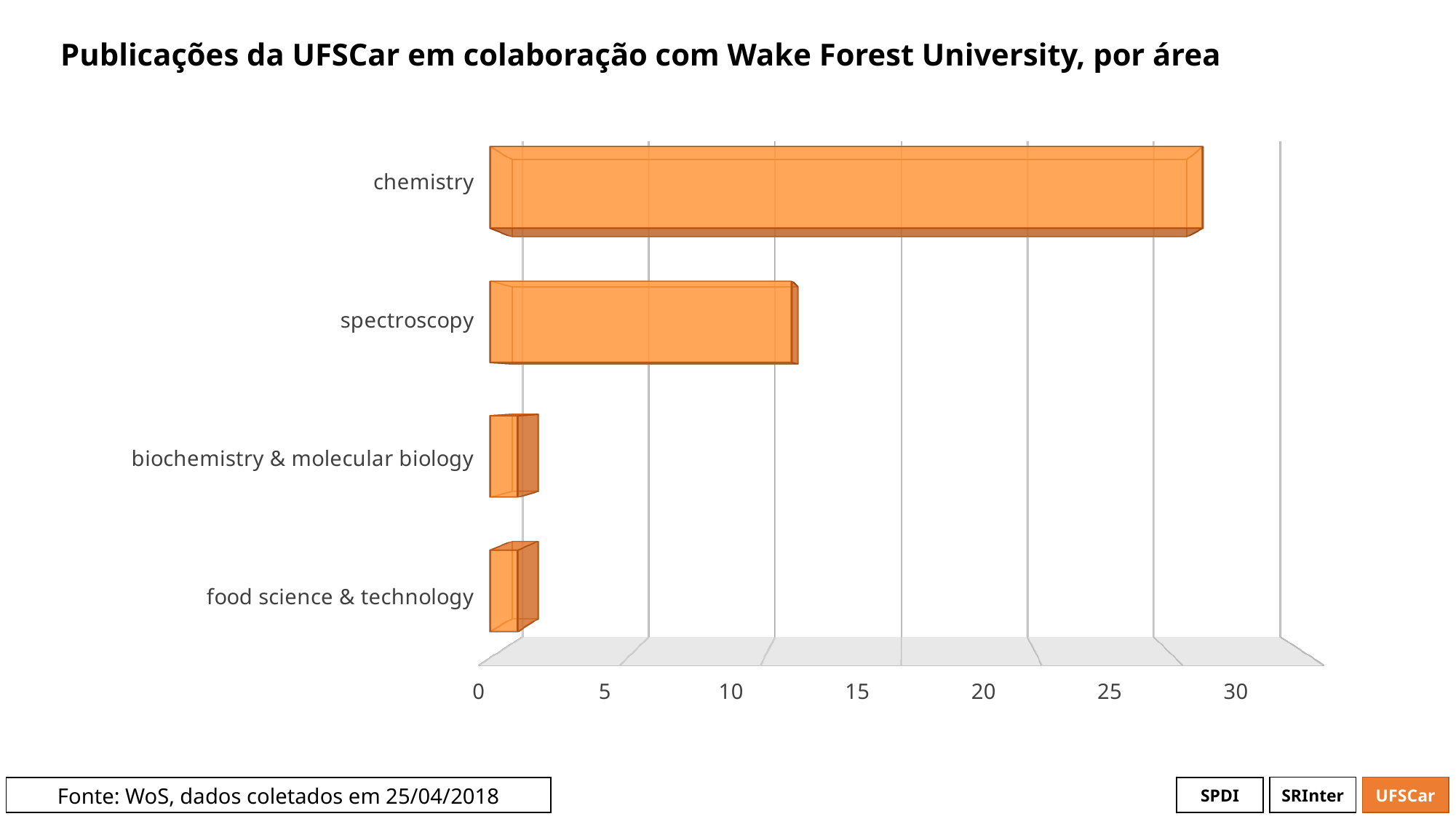
Which area has the highest number of publications? chemistry Which has more publications, spectroscopy or food science & technology? spectroscopy Is the value for spectroscopy greater or less than 15? less Is the value for chemistry greater or less than 25? greater How many areas (categories) are plotted in the chart? 4 Is the value for spectroscopy greater or less than 10? greater What kind of chart is shown on the slide? bar chart Which has more publications, chemistry or spectroscopy? chemistry What is the title of the chart? Publicações da UFSCar em colaboração com Wake Forest University, por área